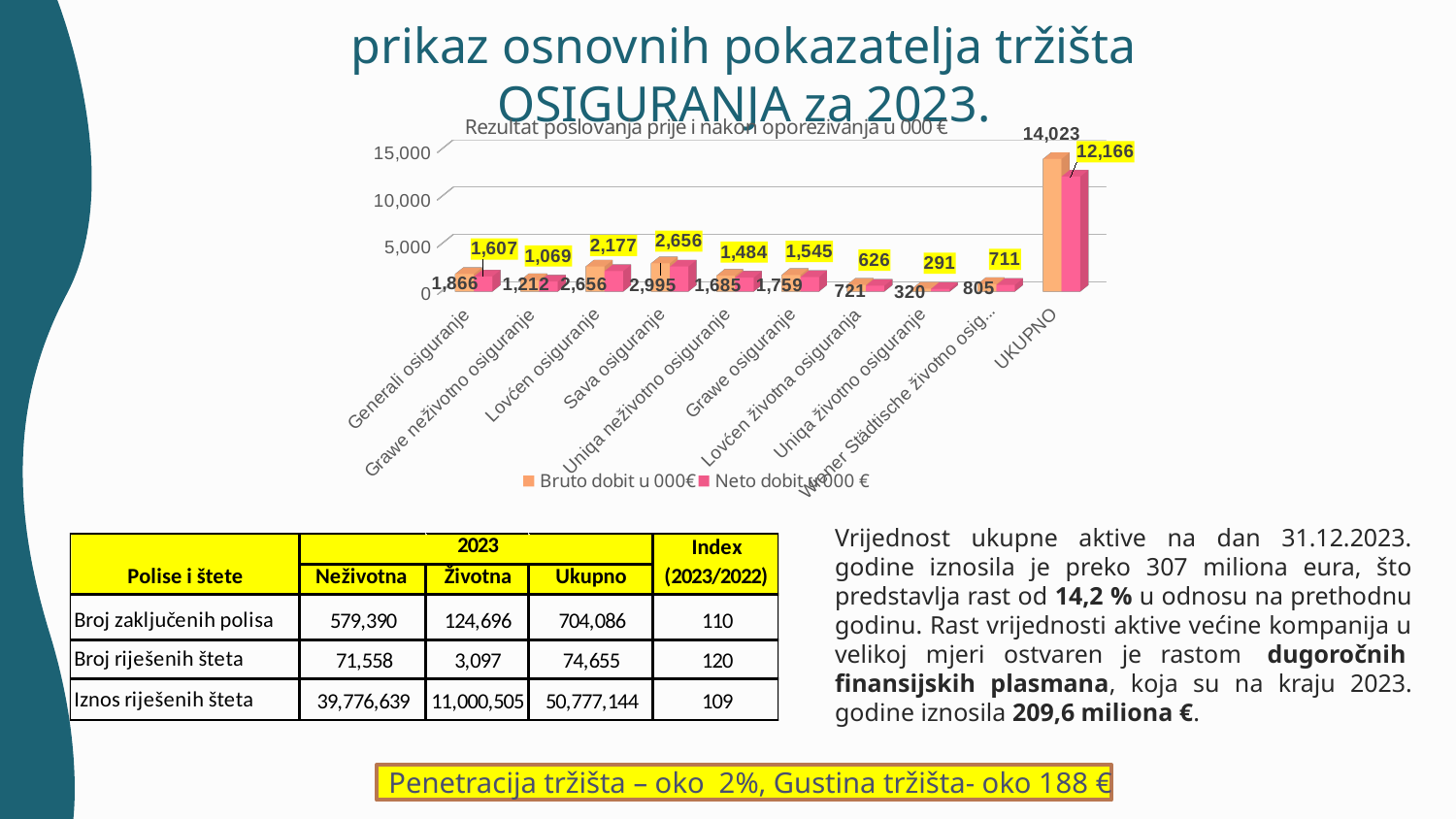
What is the Bruto dobit value for UKUPNO? 14,023 How many series does the chart legend list? 2 Is the Bruto dobit value for UKUPNO greater or less than 10,000? greater What is the Neto dobit value for UKUPNO? 12,166 What is the Bruto dobit value for Sava osiguranje? 2,995 What is the Neto dobit value for Uniqa životno osiguranje? 291 Which category has the lowest Bruto dobit? Uniqa životno osiguranje What kind of chart is shown on the slide? Bar chart Which has a larger Bruto dobit, Lovćen osiguranje or Grawe neživotno osiguranje? Lovćen osiguranje How many categories are shown on the x axis of the chart? 10 Which individual company (excluding UKUPNO) has the highest Bruto dobit? Sava osiguranje What is the difference between Bruto dobit and Neto dobit for UKUPNO? 1,857